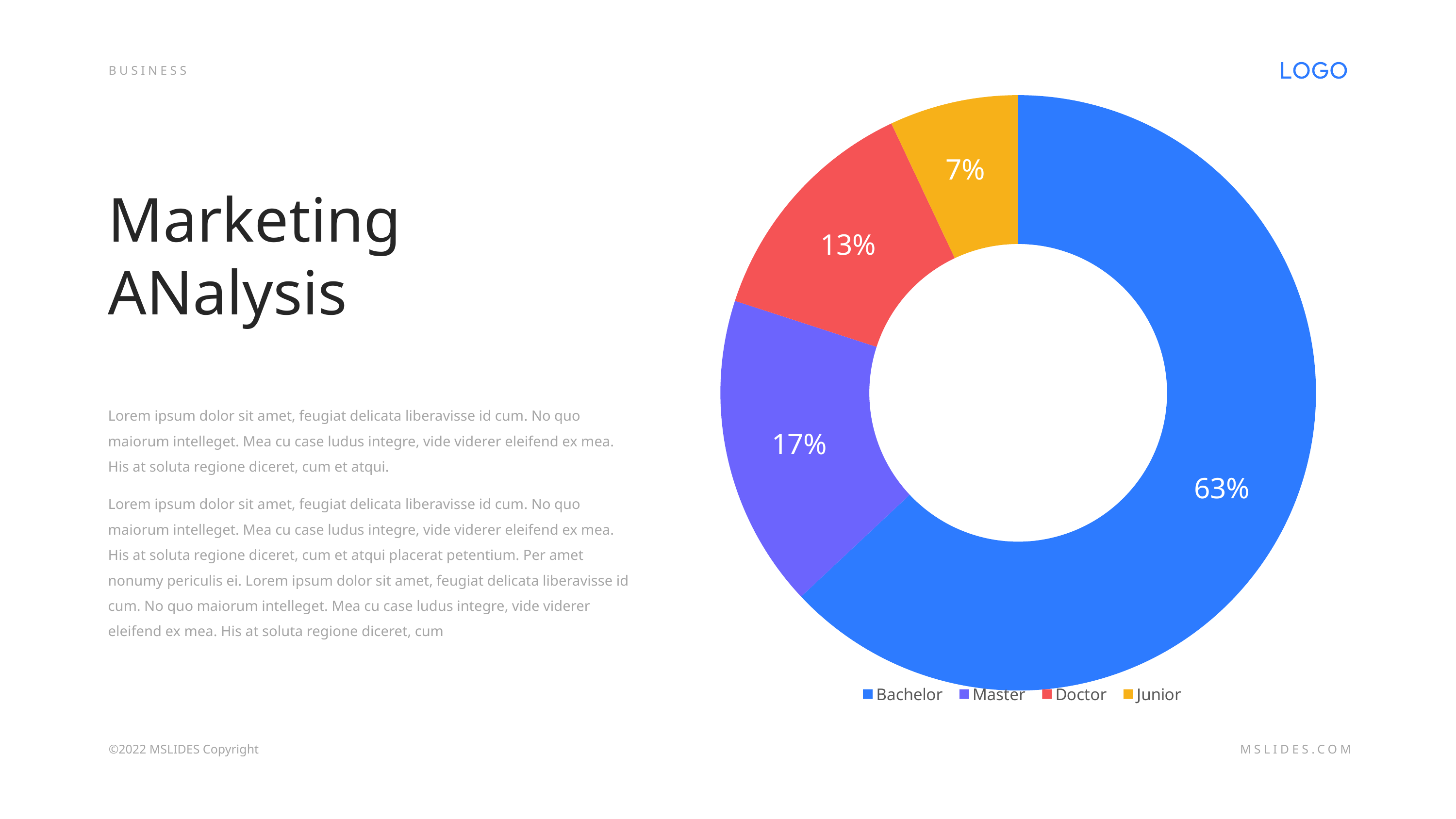
Which category has the smallest share of the pie chart? Junior What is the difference in percentage points between the Doctor and Junior shares? 6 What percentage of the pie chart does Junior represent? 7% What percentage of the pie chart does Doctor represent? 13% What is the difference in percentage points between the Bachelor and Master shares? 46 Which has a larger share, Master or Doctor? Master What type of chart is shown on the slide? Doughnut chart What percentage of the pie chart does Master represent? 17% How many categories are shown in the pie chart? 4 Which category has the largest share of the pie chart? Bachelor Which colour represents Doctor in the pie chart? Red What percentage of the pie chart does Bachelor represent? 63%